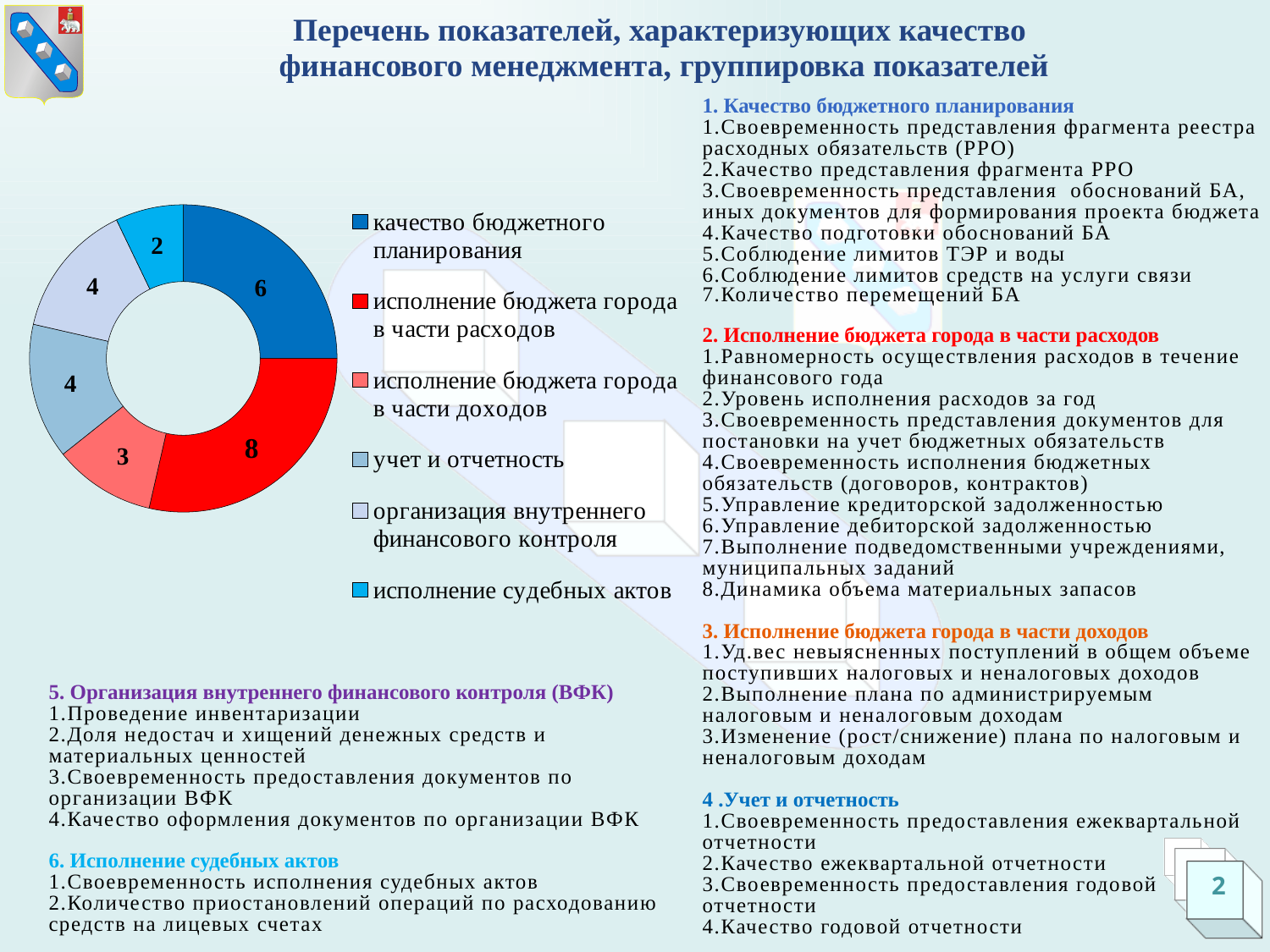
Which category has the largest slice in the chart? исполнение бюджета города в части расходов What is the difference between the values for "исполнение бюджета города в части расходов" and "качество бюджетного планирования"? 2 What is the value for "исполнение бюджета города в части расходов" in the chart? 8 What kind of chart is shown on the slide? doughnut (pie) chart Which category has the smallest slice in the chart? исполнение судебных актов What is the value for "качество бюджетного планирования" in the chart? 6 How many categories does the chart show? 6 What is the total of all values shown in the chart? 27 What is the value for "исполнение судебных актов" in the chart? 2 Which is larger: the value for "учет и отчетность" or the value for "исполнение бюджета города в части доходов"? учет и отчетность What colour is the slice for "исполнение бюджета города в части расходов"? red What is the value for "исполнение бюджета города в части доходов" in the chart? 3